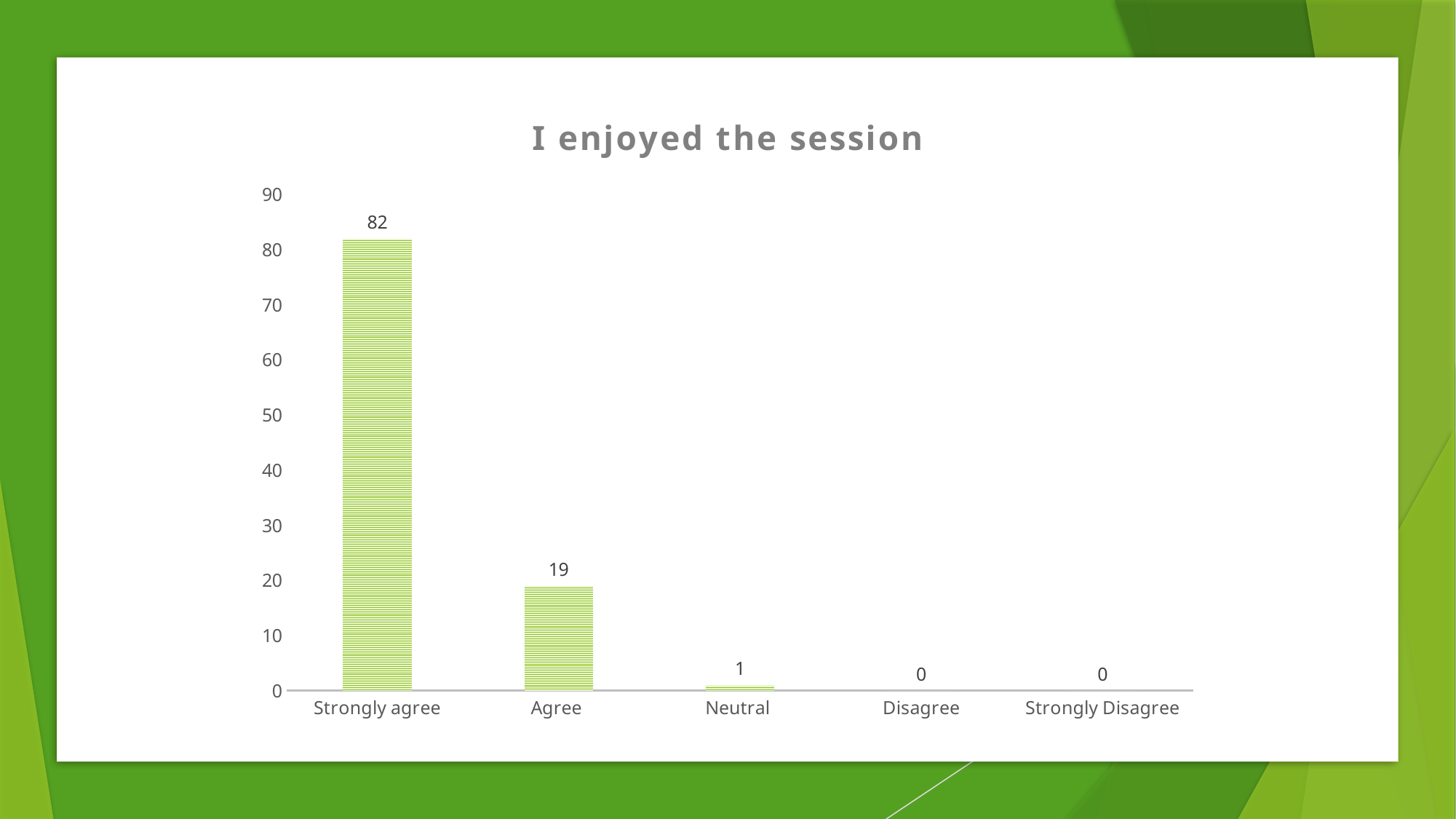
What is the difference between the values for Strongly agree and Agree? 63 What is the value for Neutral? 1 What is the value for Strongly agree? 82 What kind of chart is shown on the slide? bar chart Is the value for Strongly agree greater or less than 70? greater Which is larger, the value for Agree or the value for Neutral? Agree Do the values rise or fall from left to right along the x axis? fall How many categories are shown on the x axis? 5 What is the value for Disagree? 0 Which category has the highest value? Strongly agree What is the title of the chart? I enjoyed the session What is the value for Agree? 19